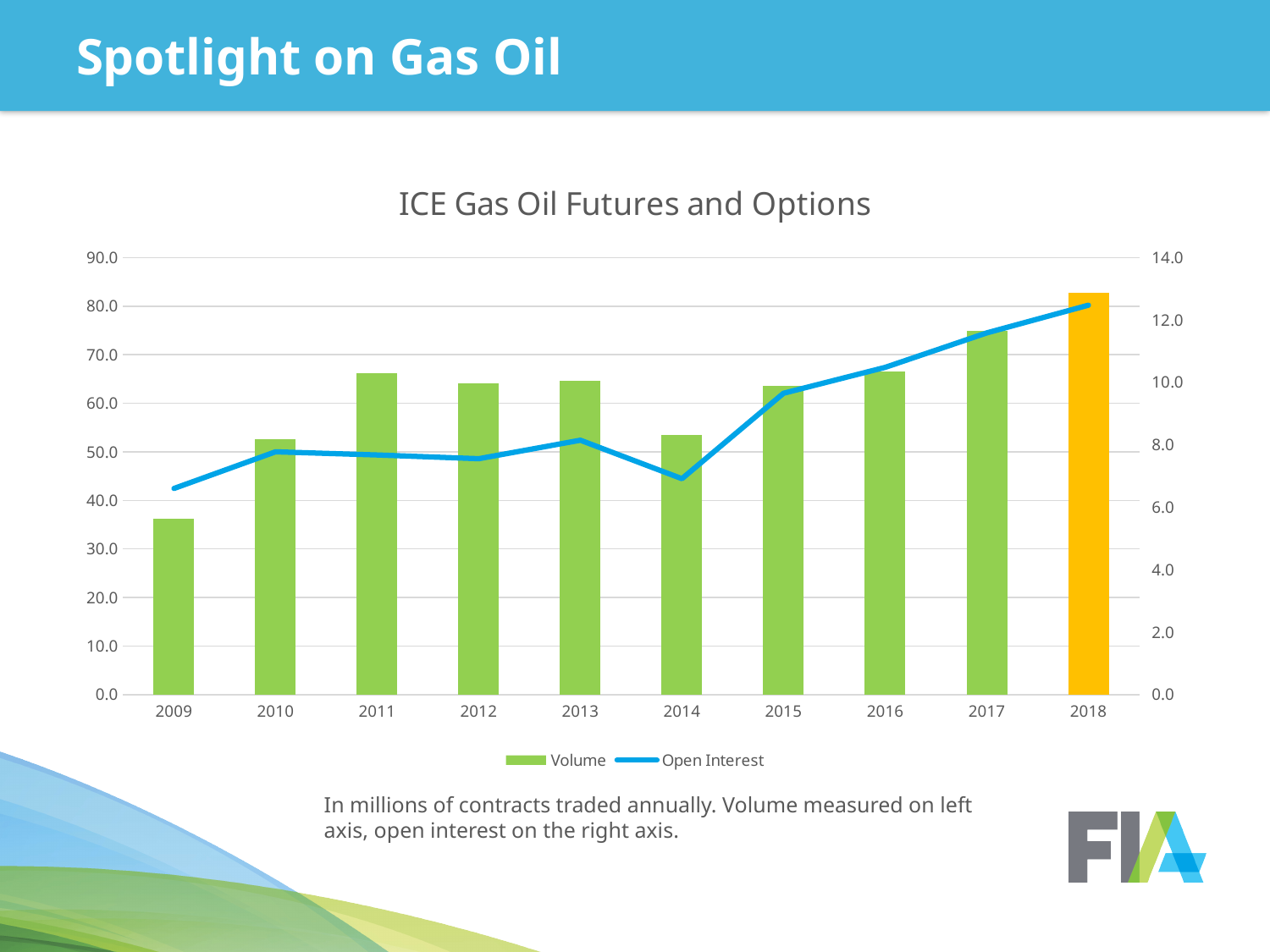
Which year has the larger Volume, 2014 or 2017? 2017 What kind of chart is shown on the slide? A combination bar and line chart Which year has the highest Volume? 2018 Is the Open Interest for 2015 greater or less than 10.0? less Is the Volume for 2009 greater or less than 40.0? less Does Open Interest rise or fall from 2014 to 2018? rise Which year has the lowest Volume? 2009 Is the Volume for 2018 greater or less than 80.0? greater Which year has the highest Open Interest? 2018 How many series does the legend list? 2 What is the title of the chart? ICE Gas Oil Futures and Options How many years are shown on the x axis? 10